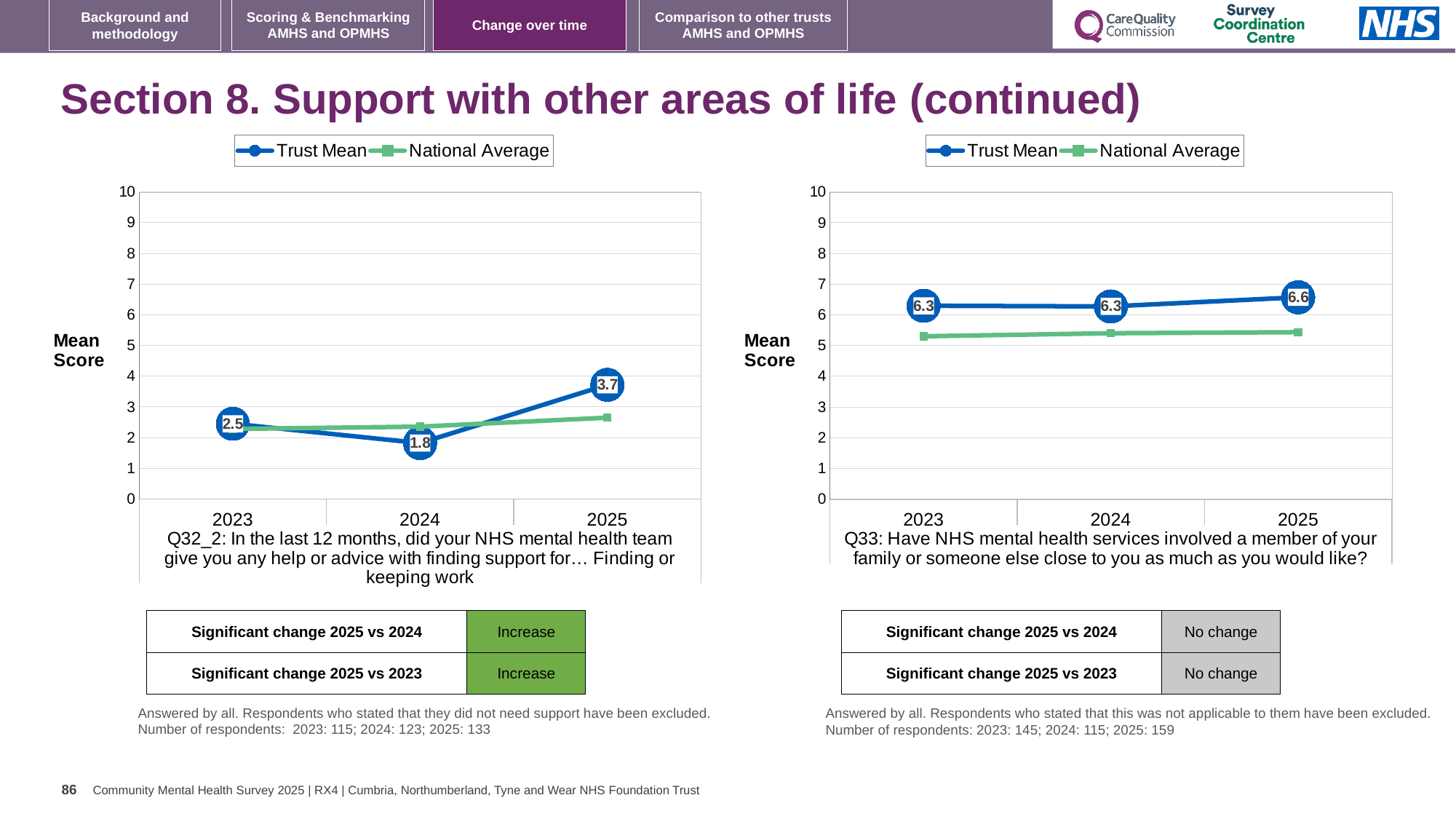
In the right chart (Q33), is the National Average for 2023 greater or less than 6? less In the left chart (Q32_2), what is the Trust Mean for 2024? 1.8 How many series does the legend of the left chart list? 2 In the left chart (Q32_2), what is the difference between the Trust Mean in 2025 and in 2024? 1.9 In the right chart (Q33), what is the Trust Mean for 2023? 6.3 What kind of chart is the right chart (Q33)? Line chart In the right chart (Q33), which is larger in 2025, the Trust Mean or the National Average? Trust Mean In the left chart (Q32_2), what is the Trust Mean for 2025? 3.7 In the left chart (Q32_2), which year has the lowest Trust Mean? 2024 In the right chart (Q33), what is the difference between the Trust Mean in 2025 and in 2023? 0.3 In the left chart (Q32_2), which year has the highest Trust Mean? 2025 In the right chart (Q33), what is the Trust Mean for 2025? 6.6